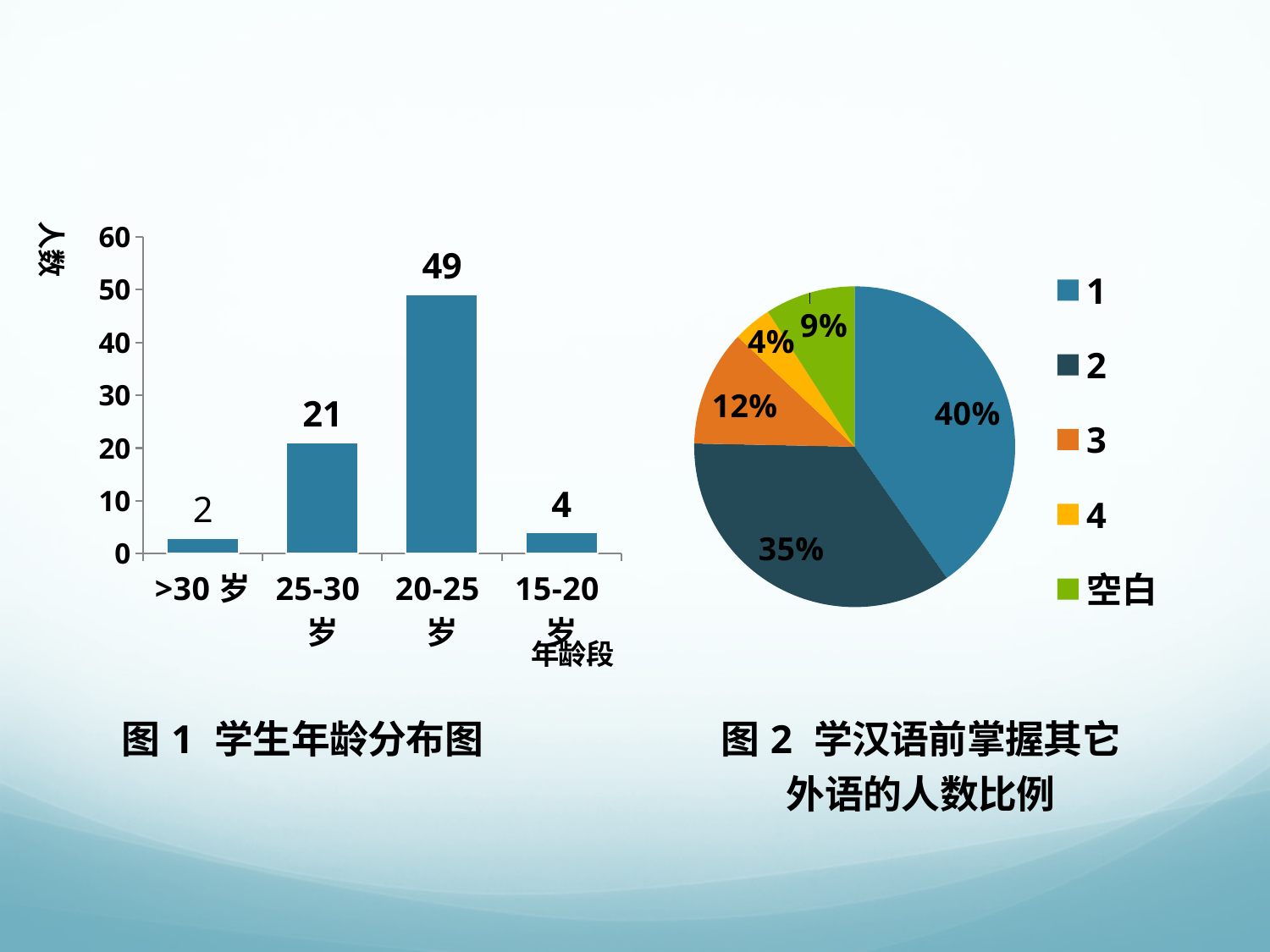
In the bar chart (图 1 学生年龄分布图), which is larger, the value for 15-20 岁 or the value for >30 岁? 15-20 岁 What kind of chart is 图 1 学生年龄分布图? Bar chart In the bar chart (图 1 学生年龄分布图), what is the value for the 25-30 岁 age group? 21 In the bar chart (图 1 学生年龄分布图), what is the value for the 20-25 岁 age group? 49 In the pie chart (图 2), what share does category 2 have? 35% In the bar chart (图 1 学生年龄分布图), how many age groups are shown on the x axis? 4 In the pie chart (图 2), how many entries does the legend list? 5 In the bar chart (图 1 学生年龄分布图), which age group has the lowest number of students? >30 岁 In the bar chart (图 1 学生年龄分布图), which age group has the highest number of students? 20-25 岁 In the pie chart (图 2), what is the difference between the shares of category 1 and category 3? 28% In the pie chart (图 2), which category has the smallest slice? 4 In the bar chart (图 1 学生年龄分布图), what is the difference between the values for 20-25 岁 and 25-30 岁? 28